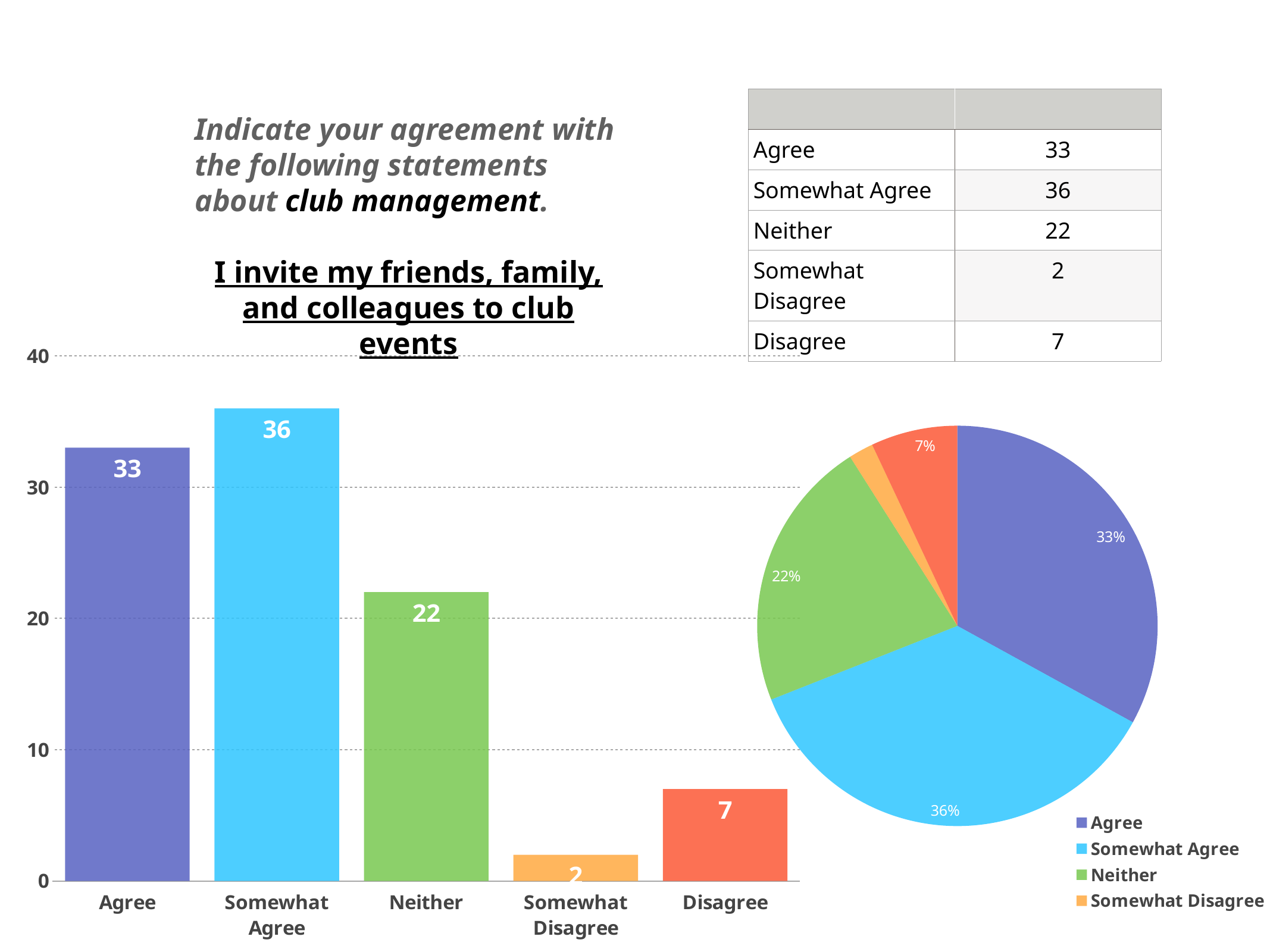
In the bar chart, what is the value for Somewhat Agree? 36 In the bar chart, which is larger, the value for Disagree or the value for Somewhat Disagree? Disagree What kind of chart is the chart on the right of the slide? pie chart In the bar chart, which category has the highest value? Somewhat Agree In the bar chart, which category has the lowest value? Somewhat Disagree In the bar chart, what is the value for Neither? 22 How many categories are shown in the bar chart? 5 In the pie chart, what share is shown for the Neither slice? 22% In the bar chart, is the value for Agree greater or less than 30? greater In the pie chart, what share is shown for the Somewhat Agree slice? 36% In the bar chart, what is the difference between the values for Somewhat Agree and Agree? 3 What kind of chart is the chart on the left of the slide? bar chart